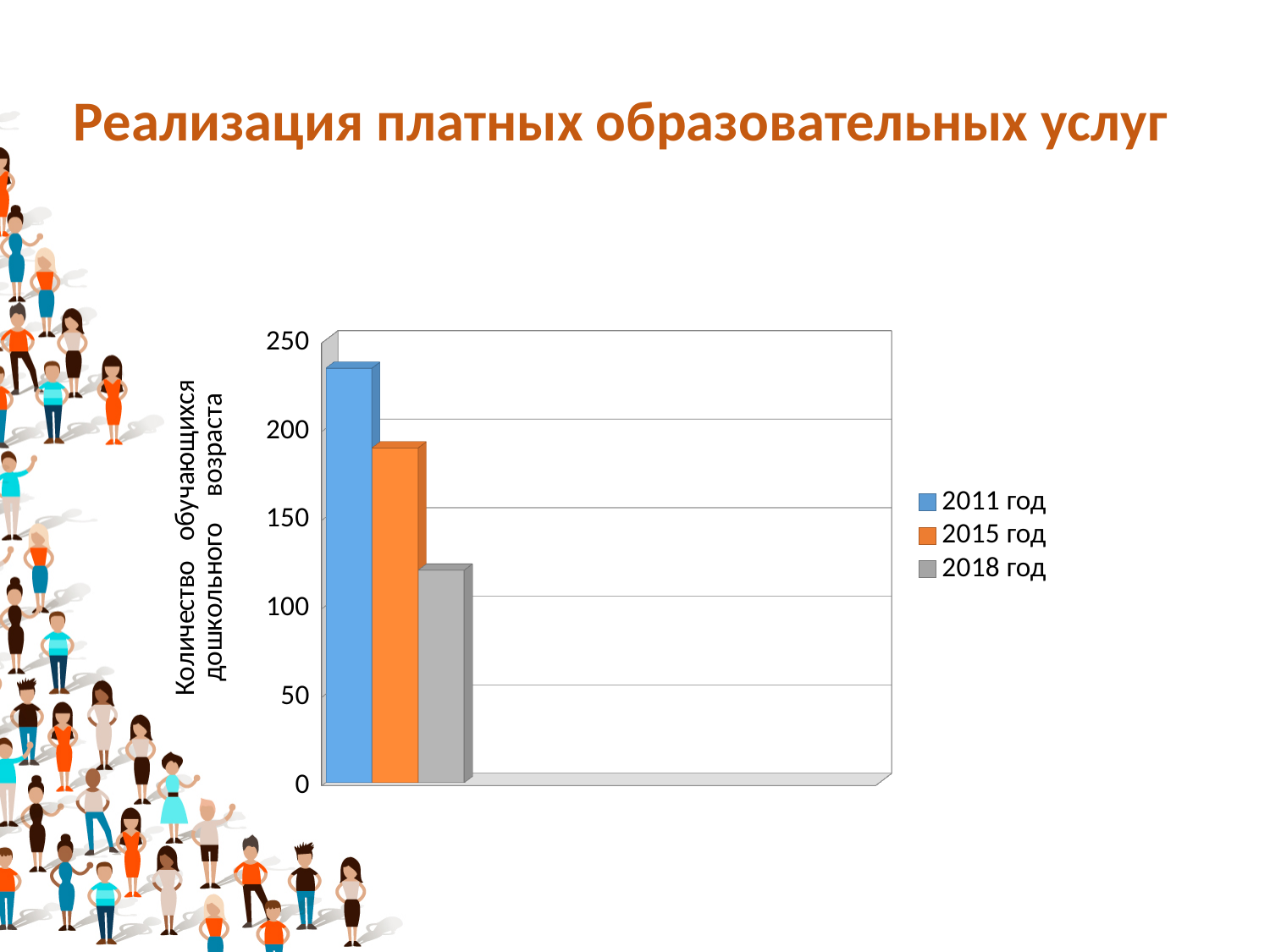
Is the value for 2018 год greater or less than 150? less Which is larger, the value for 2011 год or the value for 2015 год? 2011 год What colour is the bar for 2015 год? orange Which series has the highest value? 2011 год Do the values rise or fall from 2011 год to 2018 год? fall Is the value for 2011 год greater or less than 200? greater How many series does the legend list? 3 Which is larger, the value for 2015 год or the value for 2018 год? 2015 год What kind of chart is shown on the slide? bar chart Which series has the lowest value? 2018 год What is the title of the slide? Реализация платных образовательных услуг Is the value for 2015 год greater or less than 200? less